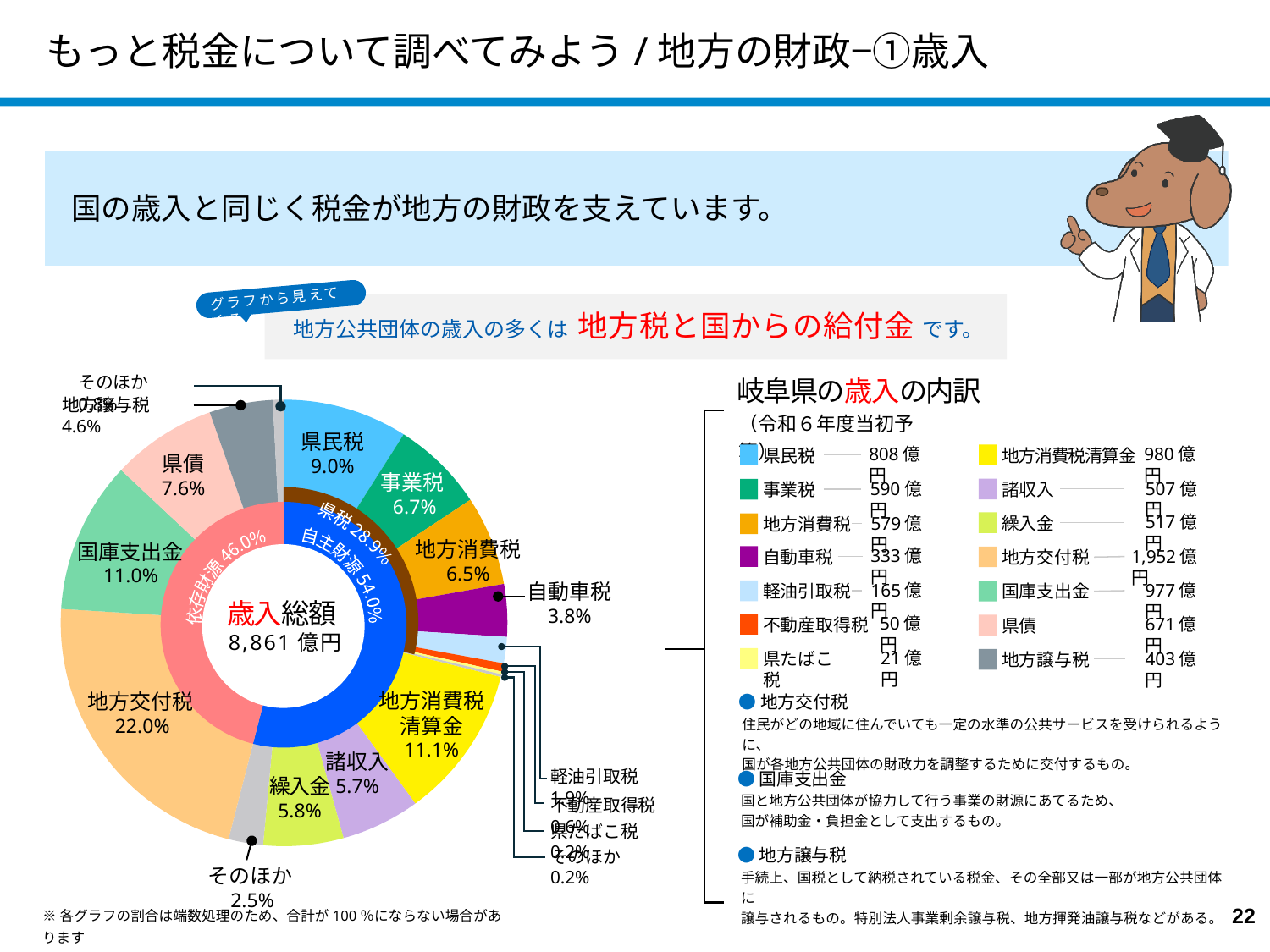
歳入の内訳で最も割合が大きい項目はどれですか？ 地方交付税 内側の輪で、自主財源の割合は何％ですか？ 54.0% このグラフはどの種類のグラフですか？ 円グラフ 凡例によると、事業税の金額はいくらですか？ 590 億円 凡例によると、地方交付税の金額はいくらですか？ 1,952 億円 県債と地方譲与税では、どちらの割合が大きいですか？ 県債 グラフのタイトルは何ですか？ 岐阜県の歳入の内訳 地方交付税の割合は何％ですか？ 22.0% 歳入総額はいくらですか？ 8,861 億円 内側の輪で、依存財源の割合は何％ですか？ 46.0% 地方交付税と国庫支出金の割合の差は何ポイントですか？ 11.0% 県民税の割合は何％ですか？ 9.0%